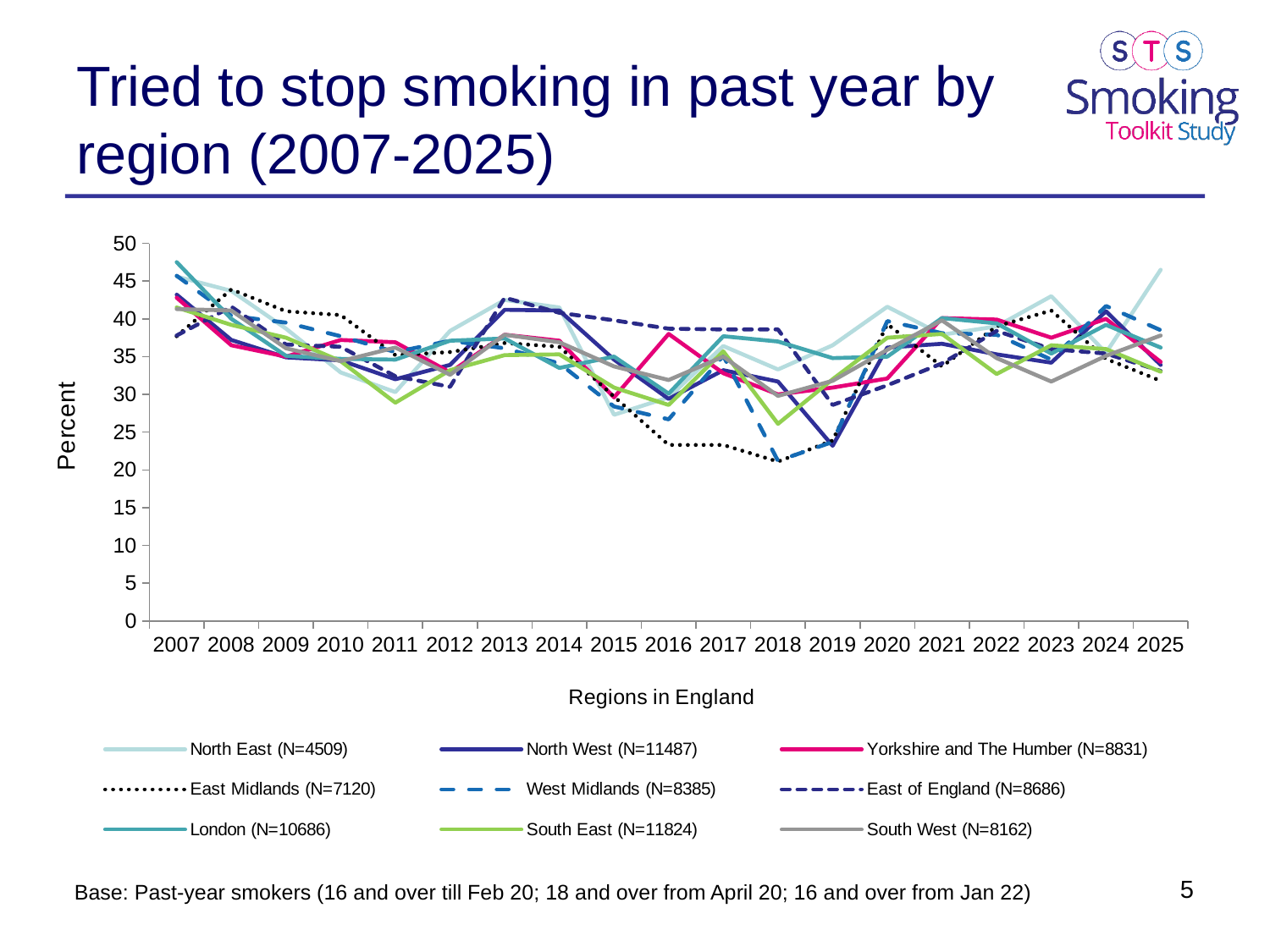
Is the value for East of England in 2016 greater or less than 35? greater Is the value for East Midlands in 2018 greater or less than 25? less Which region has the highest value in 2025? North East Is the value for North East in 2025 greater or less than 40? greater What is the label on the y axis? Percent Which region has the lowest value in 2016? East Midlands What kind of chart is shown on the slide? line chart Does the East Midlands line rise or fall from 2018 to 2023? rise How many series does the legend list? 9 In 2018, which is larger: the value for East Midlands or the value for East of England? East of England How many years are shown along the x axis? 19